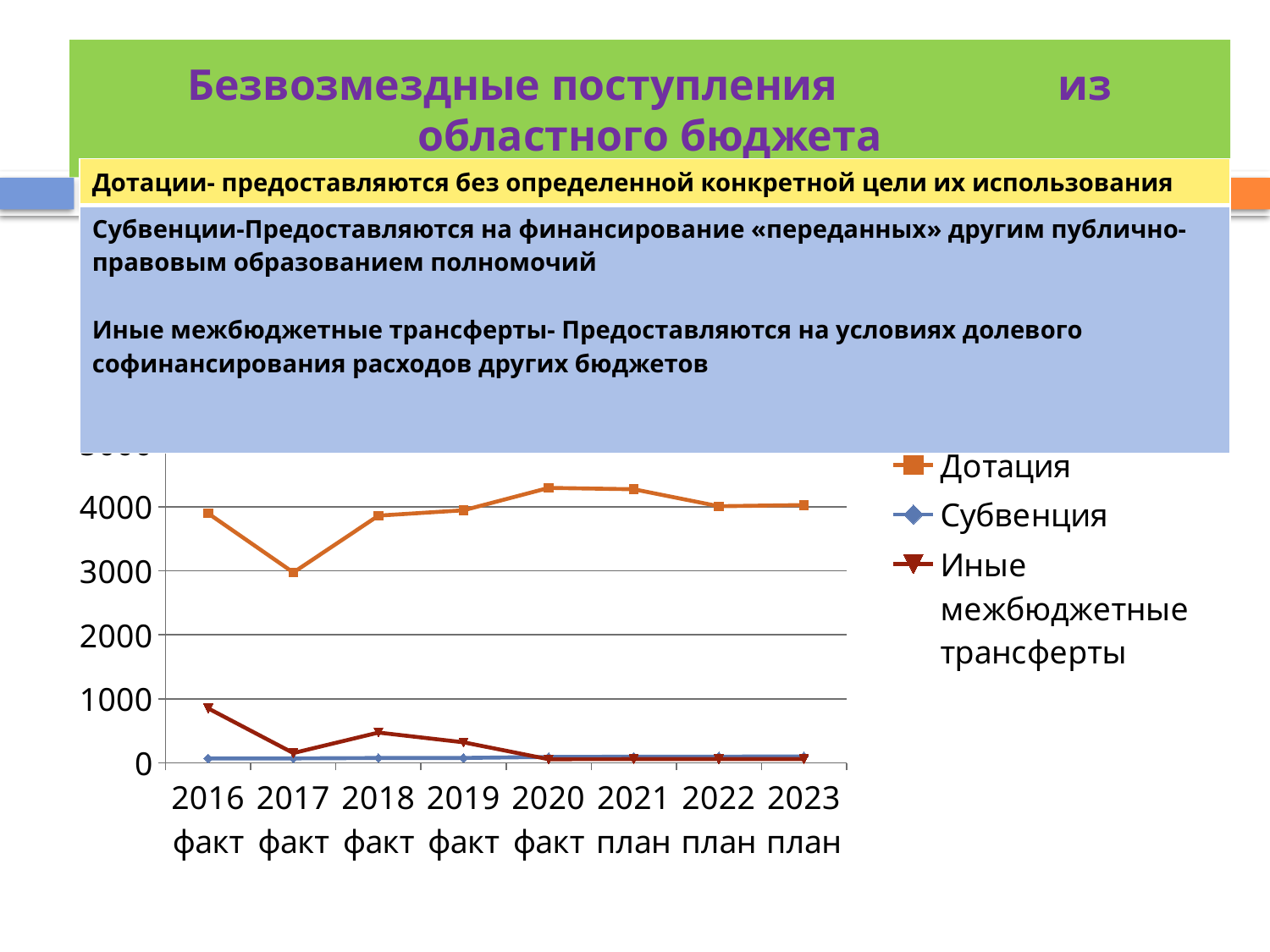
Is the value for Иные межбюджетные трансферты in 2018 факт greater or less than 1000? less What kind of chart is shown on the slide? line chart Which series is shown in orange in the chart legend? Дотация Which is larger in 2016 факт: Дотация or Иные межбюджетные трансферты? Дотация How many years are shown along the x axis of the chart? 8 Does the value for Дотация rise or fall from 2016 факт to 2017 факт? fall Is the value for Субвенция in 2019 факт greater or less than 1000? less In which year is the value for Иные межбюджетные трансферты highest? 2016 факт Is the value for Дотация in 2016 факт greater or less than 3000? greater In which year is the value for Дотация lowest? 2017 факт How many series does the chart legend list? 3